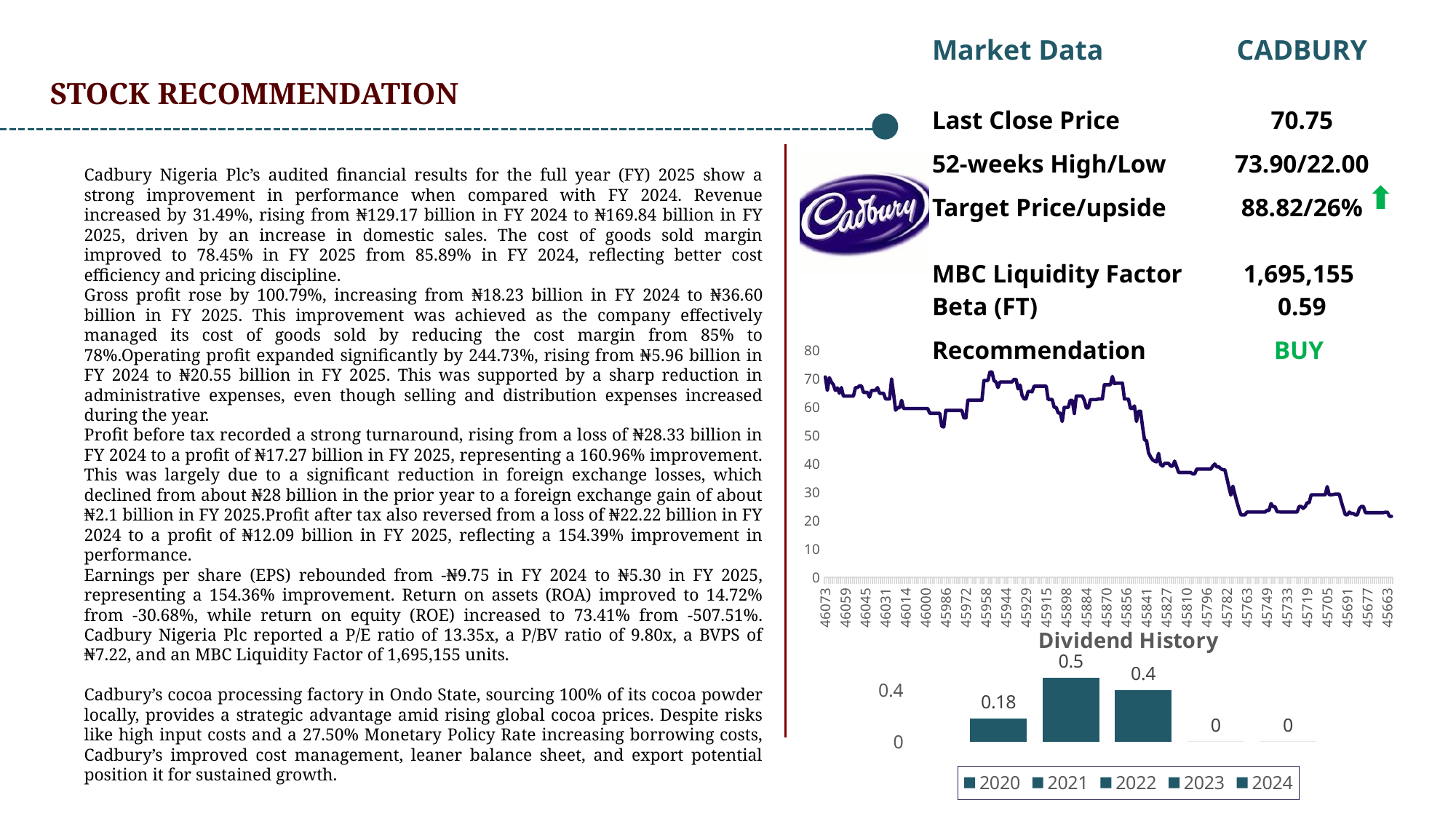
On the Dividend History chart, which is larger, the dividend for 2020 or for 2022? 2022 What kind of chart is the Dividend History chart? bar chart On the Dividend History chart, what is the dividend value for 2021? 0.5 On the Dividend History chart, what is the dividend value for 2024? 0 On the Dividend History chart, what is the difference between the 2021 and 2022 dividends? 0.1 On the Dividend History chart, what is the dividend value for 2022? 0.4 How many years are shown in the legend of the Dividend History chart? 5 On the price line chart, is the value at the rightmost point (45663) greater or less than 30? less On the price line chart, do the values generally rise or fall from left to right along the x axis? fall On the Dividend History chart, which year has the highest dividend? 2021 On the Dividend History chart, what is the dividend value for 2020? 0.18 What kind of chart is the price chart above the Dividend History chart? line chart